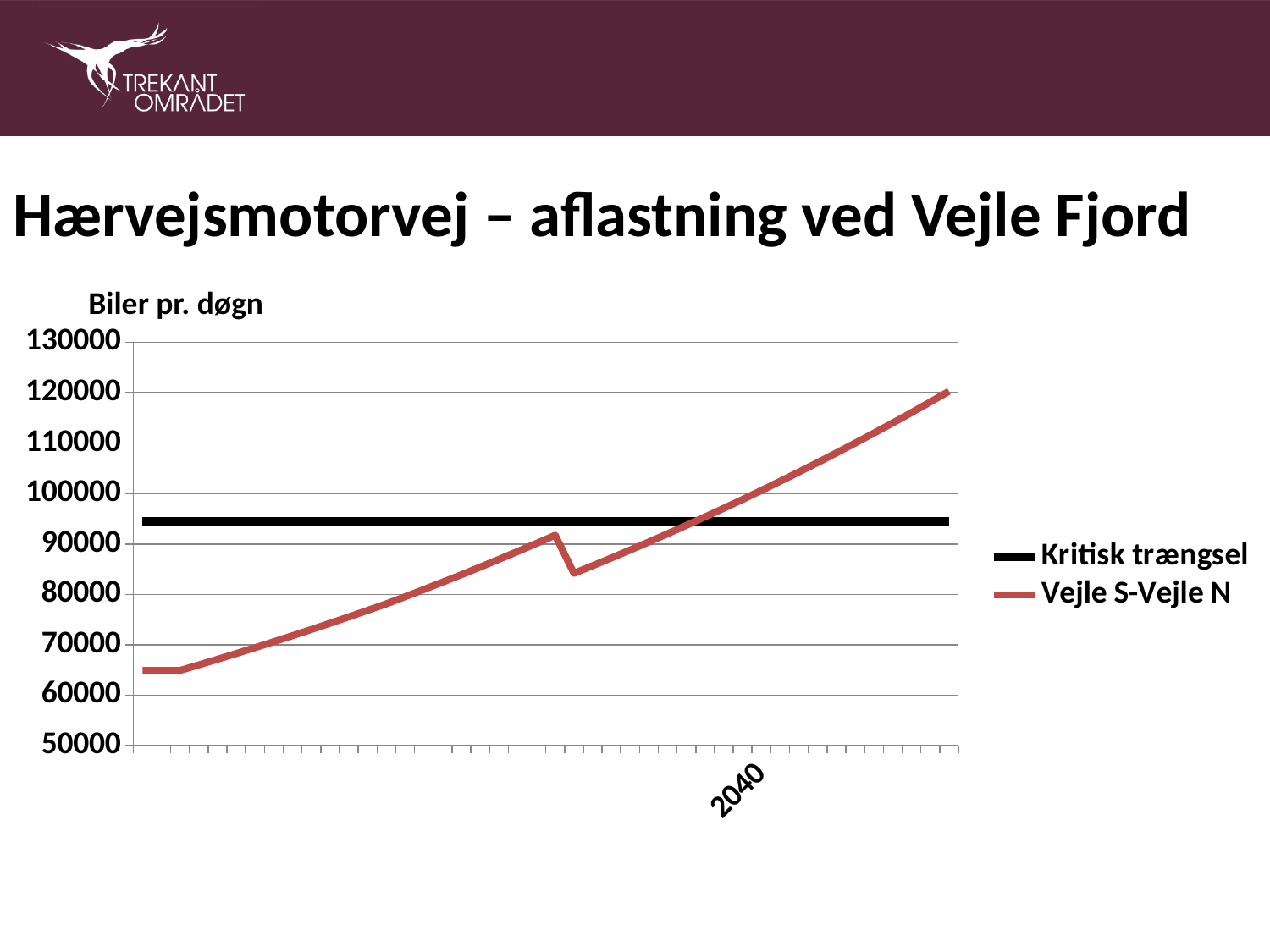
What kind of chart is shown on the slide? line chart Is the value of the Kritisk trængsel line greater or less than 90000? greater Is the value of the Kritisk trængsel line greater or less than 100000? less Which series is drawn as a black line? Kritisk trængsel At 2040, is the Vejle S-Vejle N value greater or less than 90000? greater Does the Vejle S-Vejle N line generally rise or fall along the x axis? rise What are the two series named in the legend? Kritisk trængsel and Vejle S-Vejle N How many series does the legend list? 2 What is the label shown above the vertical axis? Biler pr. døgn At 2040, which series has the higher value, Kritisk trængsel or Vejle S-Vejle N? Vejle S-Vejle N